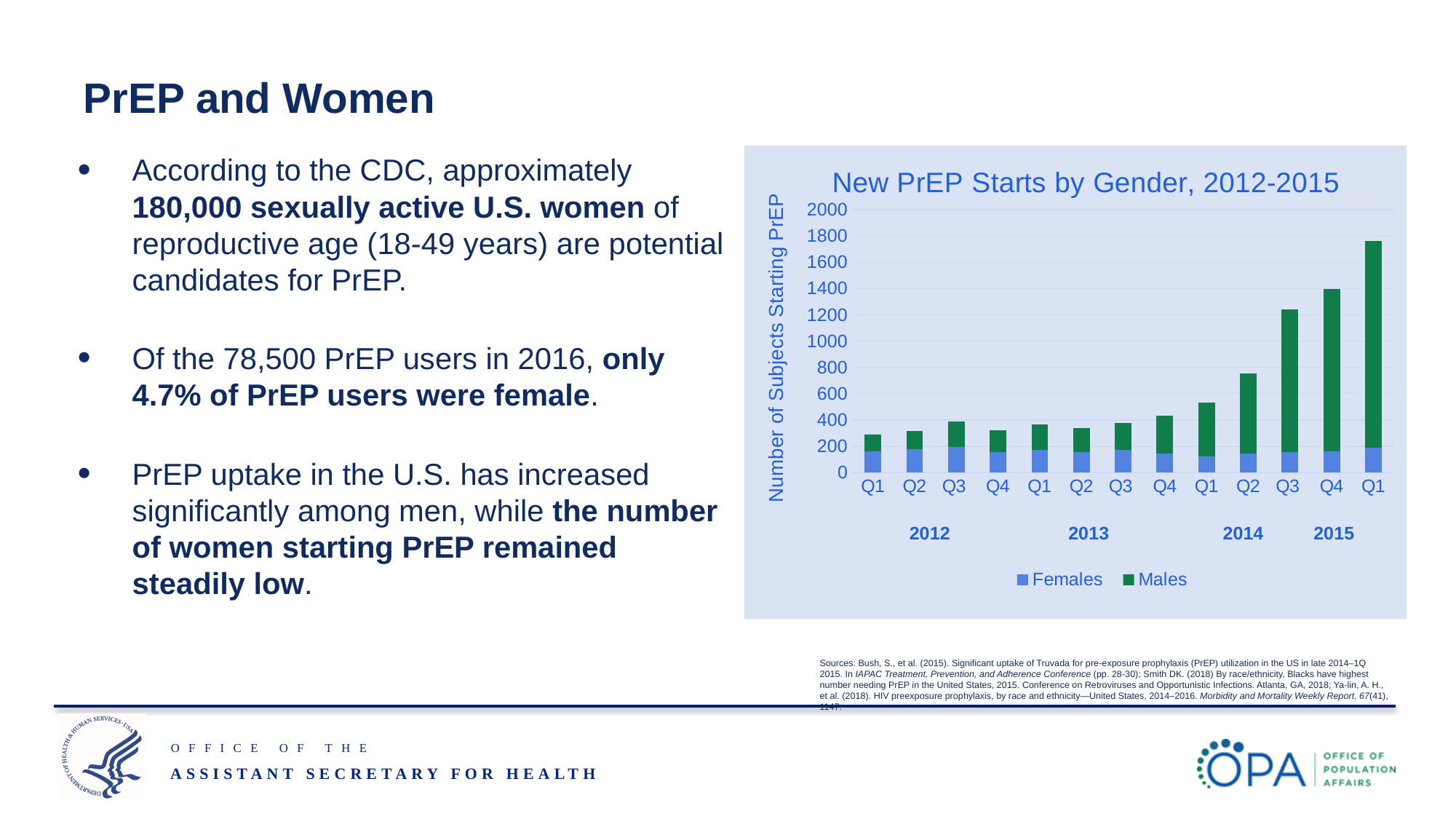
Which quarter has the highest total number of subjects starting PrEP? Q1 2015 What type of chart is shown on the slide? Stacked bar chart Is the total number of subjects starting PrEP in Q1 2012 greater or less than 400? less Is the total number of subjects starting PrEP in Q1 2015 greater or less than 1600? greater Which series is shown in green in the chart? Males Is the total number of subjects starting PrEP in Q3 2014 greater or less than 1000? greater How many quarterly bars are plotted in the chart? 13 What is the title of the chart? New PrEP Starts by Gender, 2012-2015 Does the total number of new PrEP starts generally rise or fall from Q1 2012 to Q1 2015? rise Which quarter has a larger total of new PrEP starts, Q2 2014 or Q3 2014? Q3 2014 How many series does the chart legend list? 2